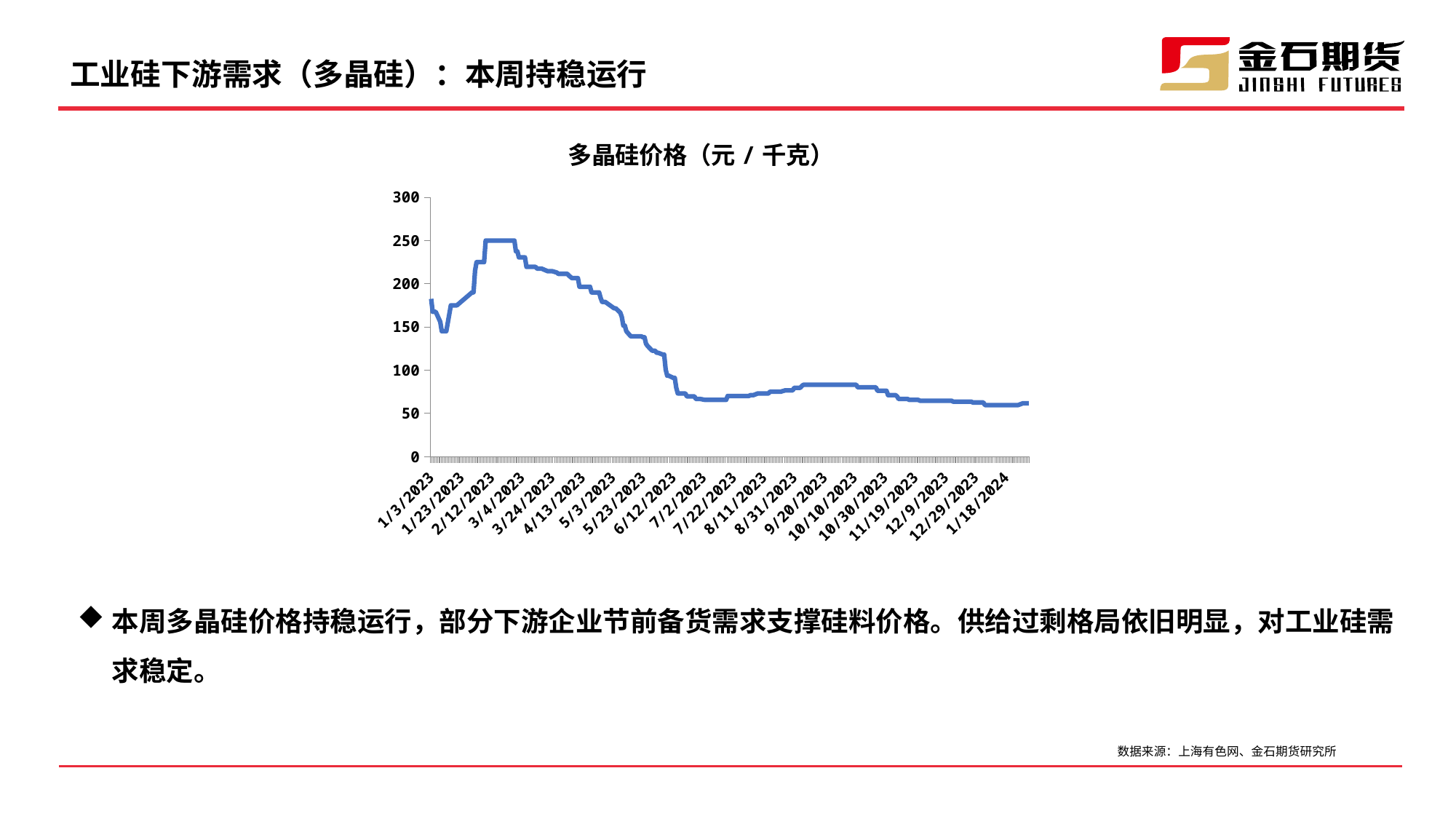
Does the line overall rise or fall from 1/3/2023 to 1/18/2024? fall What kind of chart is shown on the slide? line chart What is the highest tick shown on the y axis? 300 How many lines are plotted on the chart? 1 Is the value at 1/3/2023 greater or less than 150? greater Which is larger, the value at 1/3/2023 or the value at 1/18/2024? 1/3/2023 Is the value at 9/20/2023 greater or less than 100? less What is the title of the chart? 多晶硅价格（元 / 千克） Is the highest point of the line greater or less than 200? greater Which is larger, the value at 3/4/2023 or the value at 10/10/2023? 3/4/2023 Does the line rise or fall between 3/4/2023 and 7/2/2023? fall